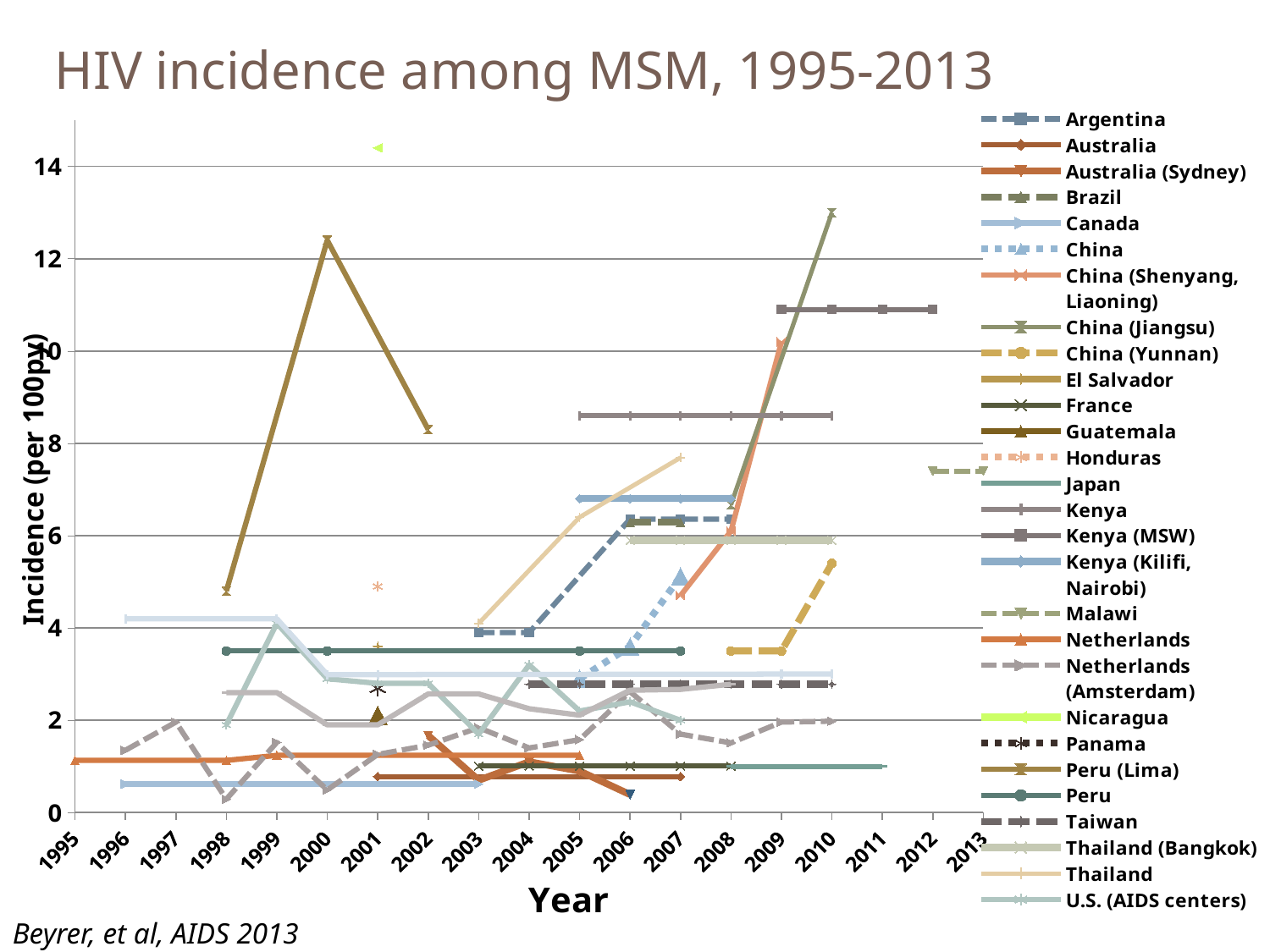
How many series does the legend list? 28 Which is larger, the value for Kenya (MSW) in 2010 or the value for Taiwan in 2010? Kenya (MSW) Is the value for Canada in 1996 greater or less than 2? less What kind of chart is shown on the slide? line chart Is the value for Kenya (MSW) in 2009 greater or less than 10? greater What is the title of the chart? HIV incidence among MSM, 1995-2013 Is the value for China (Jiangsu) in 2010 greater or less than 12? greater Does the China (Jiangsu) line rise or fall between 2008 and 2010? rise How many year ticks are shown on the x axis? 19 What is the label of the y axis? Incidence (per 100py)